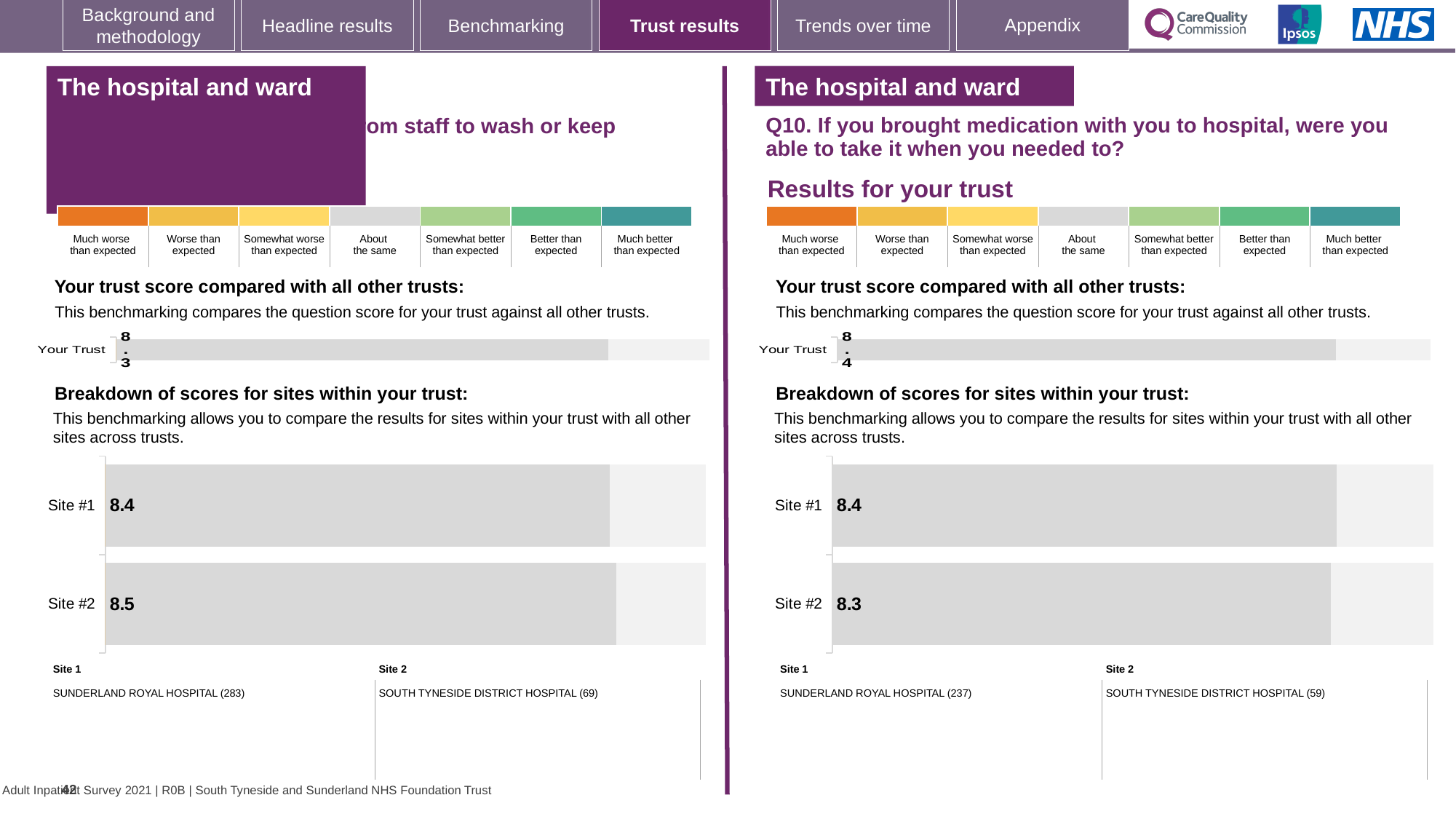
In the left-hand site breakdown chart, is the score for Site #2 larger or smaller than the score for Site #1? larger In the left-hand 'Breakdown of scores for sites within your trust' chart, what is the score for Site #1? 8.4 On the right-hand side of the slide (Q10), what is the score shown for Your Trust in the 'Your trust score compared with all other trusts' chart? 8.4 What type of chart is used for the 'Breakdown of scores for sites within your trust' on the right-hand side (Q10)? Bar chart In the right-hand 'Breakdown of scores for sites within your trust' chart (Q10), what is the score for Site #1? 8.4 In the right-hand site breakdown chart (Q10), which site has the higher score? Site #1 On the left-hand side of the slide, what is the score shown for Your Trust in the 'Your trust score compared with all other trusts' chart? 8.3 In the left-hand 'Breakdown of scores for sites within your trust' chart, what is the score for Site #2? 8.5 In the right-hand site breakdown chart (Q10), what is the difference between the Site #1 and Site #2 scores? 0.1 In the left-hand site breakdown chart, which site has the lower score? Site #1 In the right-hand 'Breakdown of scores for sites within your trust' chart (Q10), what is the score for Site #2? 8.3 How many sites are shown in the right-hand 'Breakdown of scores for sites within your trust' chart (Q10)? 2